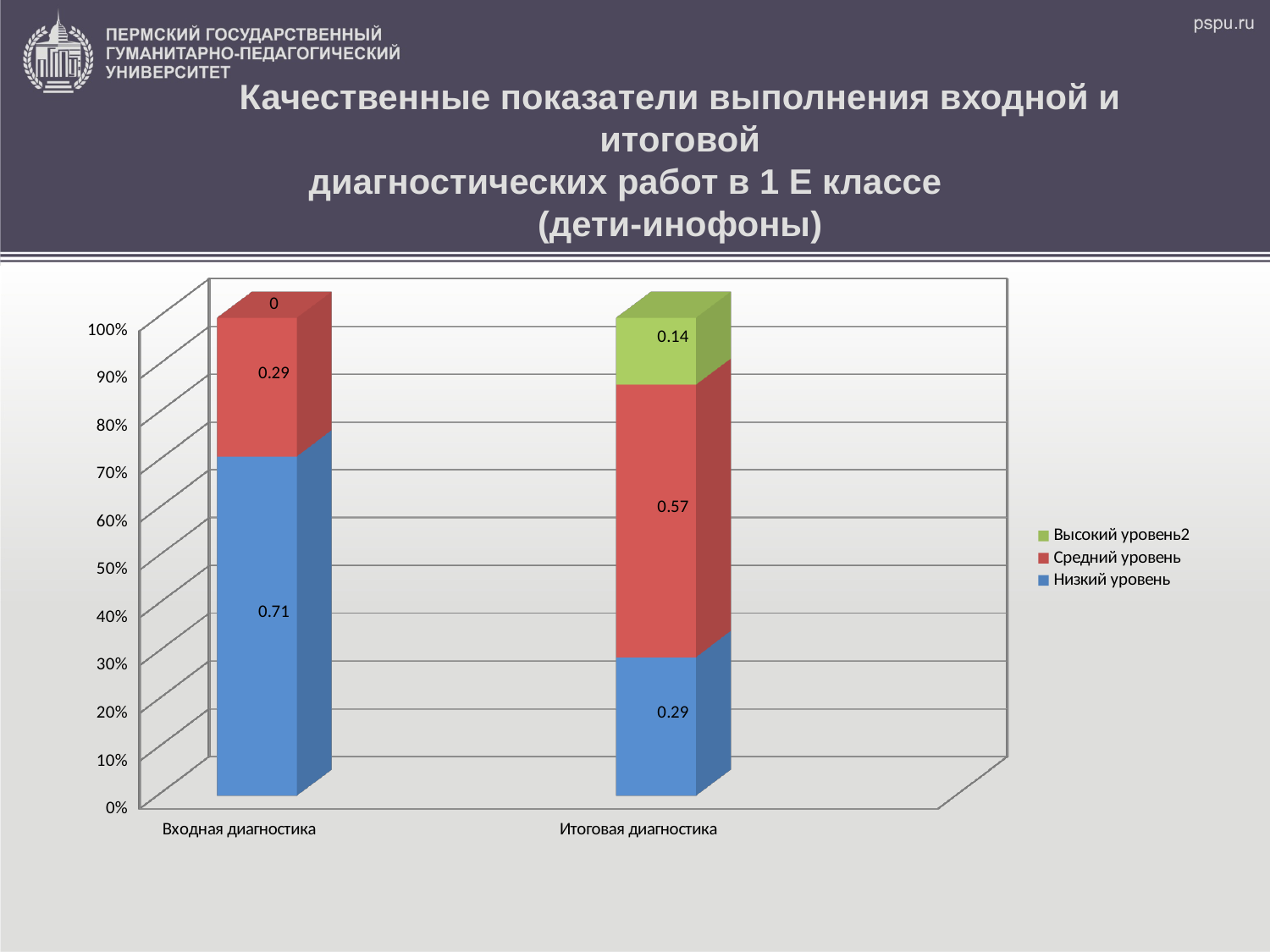
Does the value of Низкий уровень rise or fall from Входная диагностика to Итоговая диагностика? fall Which series is shown in green in the chart legend? Высокий уровень2 What kind of chart is shown on the slide? stacked bar chart Which category has the higher value for Низкий уровень, Входная диагностика or Итоговая диагностика? Входная диагностика What is the value of Низкий уровень for Входная диагностика? 0.71 What is the value of Средний уровень for Итоговая диагностика? 0.57 How many categories are shown on the x axis of the chart? 2 What is the value of Средний уровень for Входная диагностика? 0.29 What is the difference between the Низкий уровень values for Входная диагностика and Итоговая диагностика? 0.42 What is the value of Высокий уровень2 for Итоговая диагностика? 0.14 What is the value of Высокий уровень2 for Входная диагностика? 0 How many series does the chart legend list? 3